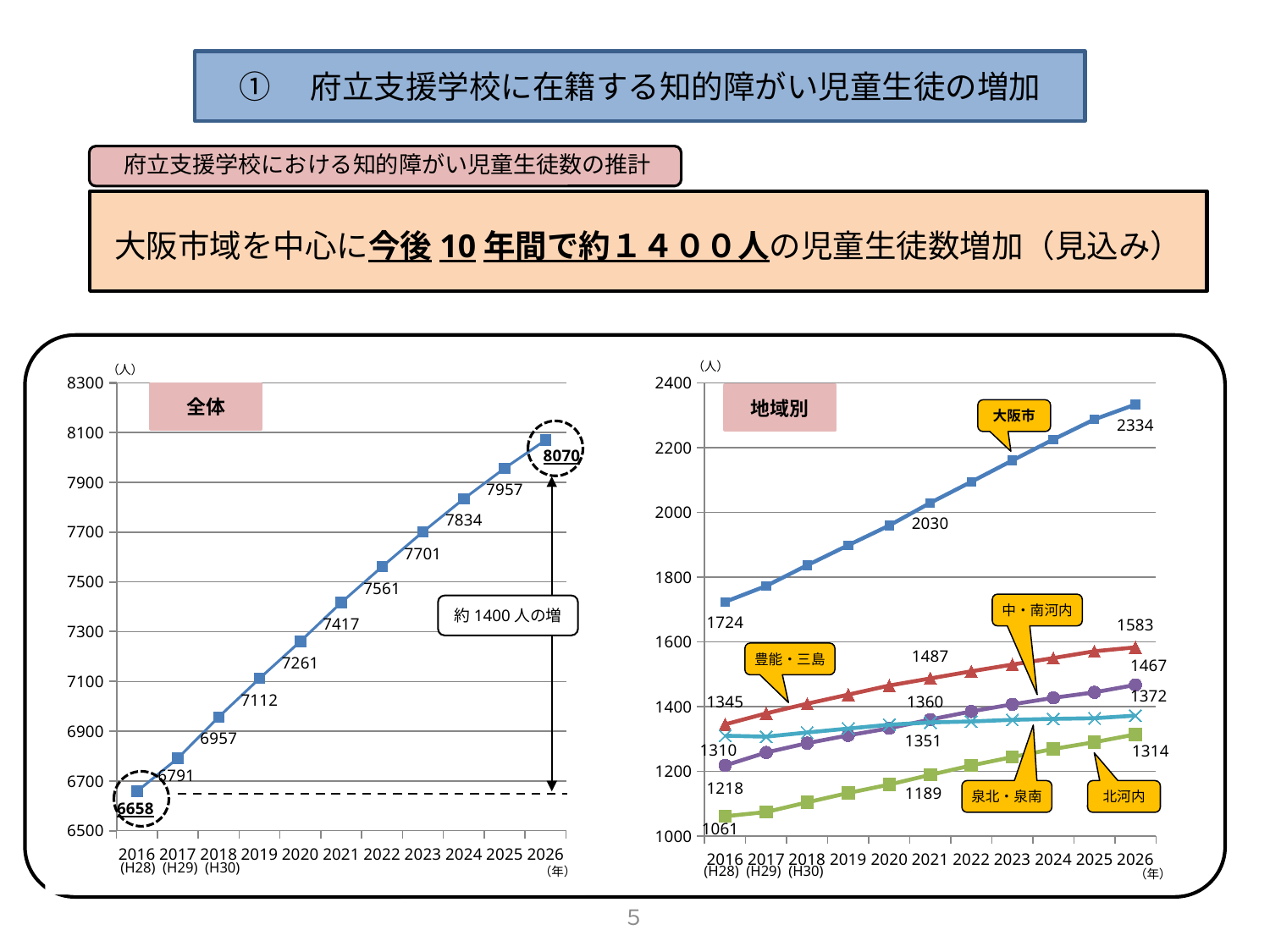
In the 全体 chart on the left, what is the value for 2016? 6658 In the 全体 chart on the left, what is the difference between the 2026 value and the 2016 value? 1412 In the 地域別 chart on the right, what is the value for 大阪市 in 2026? 2334 In the 地域別 chart on the right, how many regions (series) are plotted? 5 In the 全体 chart on the left, what is the value for 2026? 8070 In the 全体 chart on the left, what is the value for 2021? 7417 In the 地域別 chart on the right, is the value for 大阪市 in 2023 greater or less than 2000? greater What kind of chart is the 全体 chart on the left? line chart In the 地域別 chart on the right, what is the value for 大阪市 in 2016? 1724 In the 地域別 chart on the right, what is the value for 北河内 in 2021? 1189 In the 全体 chart on the left, how many years are plotted? 11 In the 全体 chart on the left, do the values rise or fall from 2016 to 2026? rise